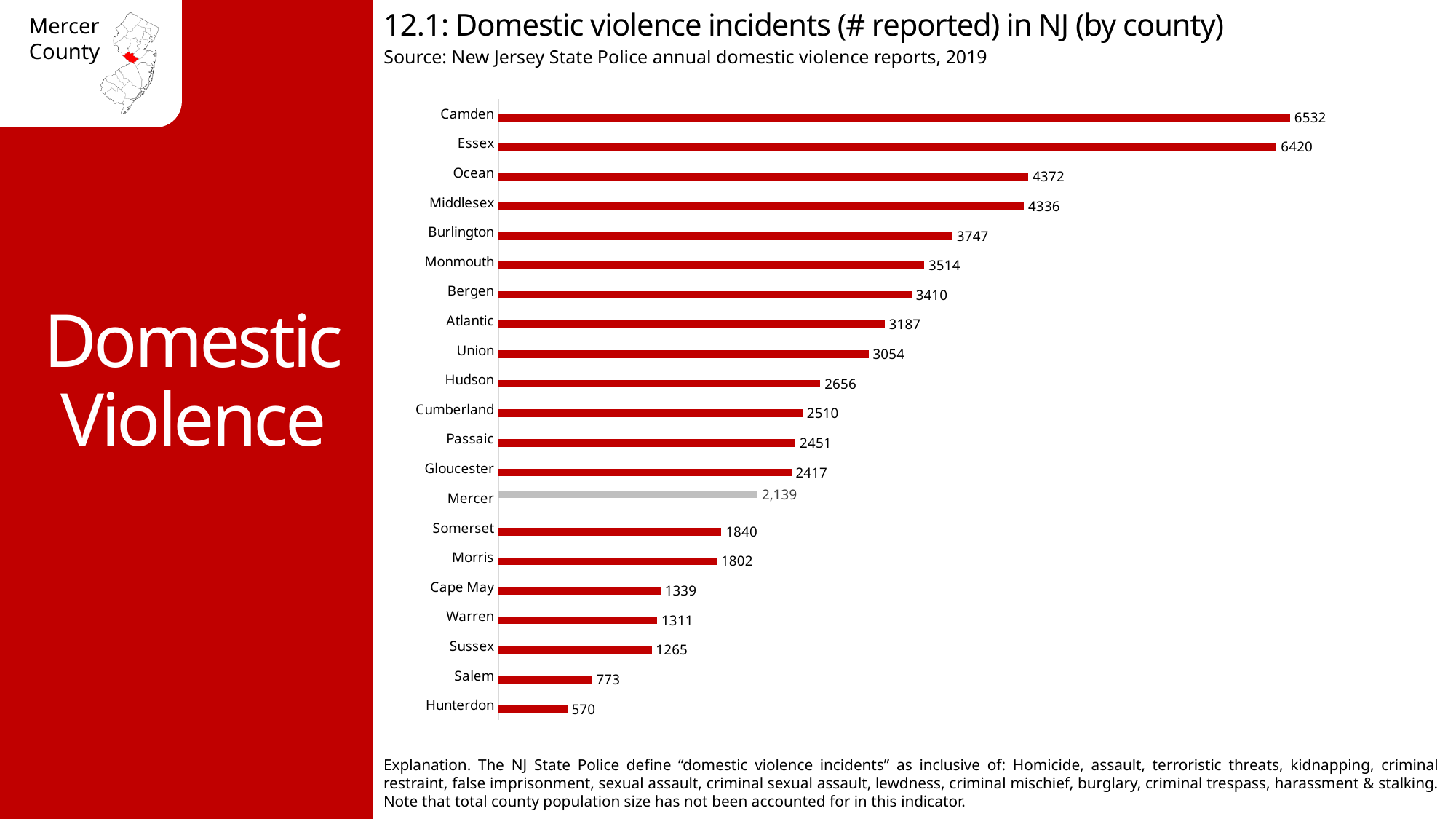
Which county's bar is shown in grey instead of red? Mercer What is the difference in reported incidents between Ocean and Middlesex? 36 What type of chart is used on this slide? Bar chart Which county has the lowest number of reported domestic violence incidents? Hunterdon How many domestic violence incidents were reported in Hunterdon County? 570 How many domestic violence incidents were reported in Camden County? 6532 Which county has more reported incidents, Burlington or Monmouth? Burlington What is the difference in reported incidents between Camden and Essex? 112 How many counties are shown in the chart? 21 Which county has more reported incidents, Salem or Sussex? Sussex Which county has the highest number of reported domestic violence incidents? Camden How many domestic violence incidents were reported in Mercer County? 2,139